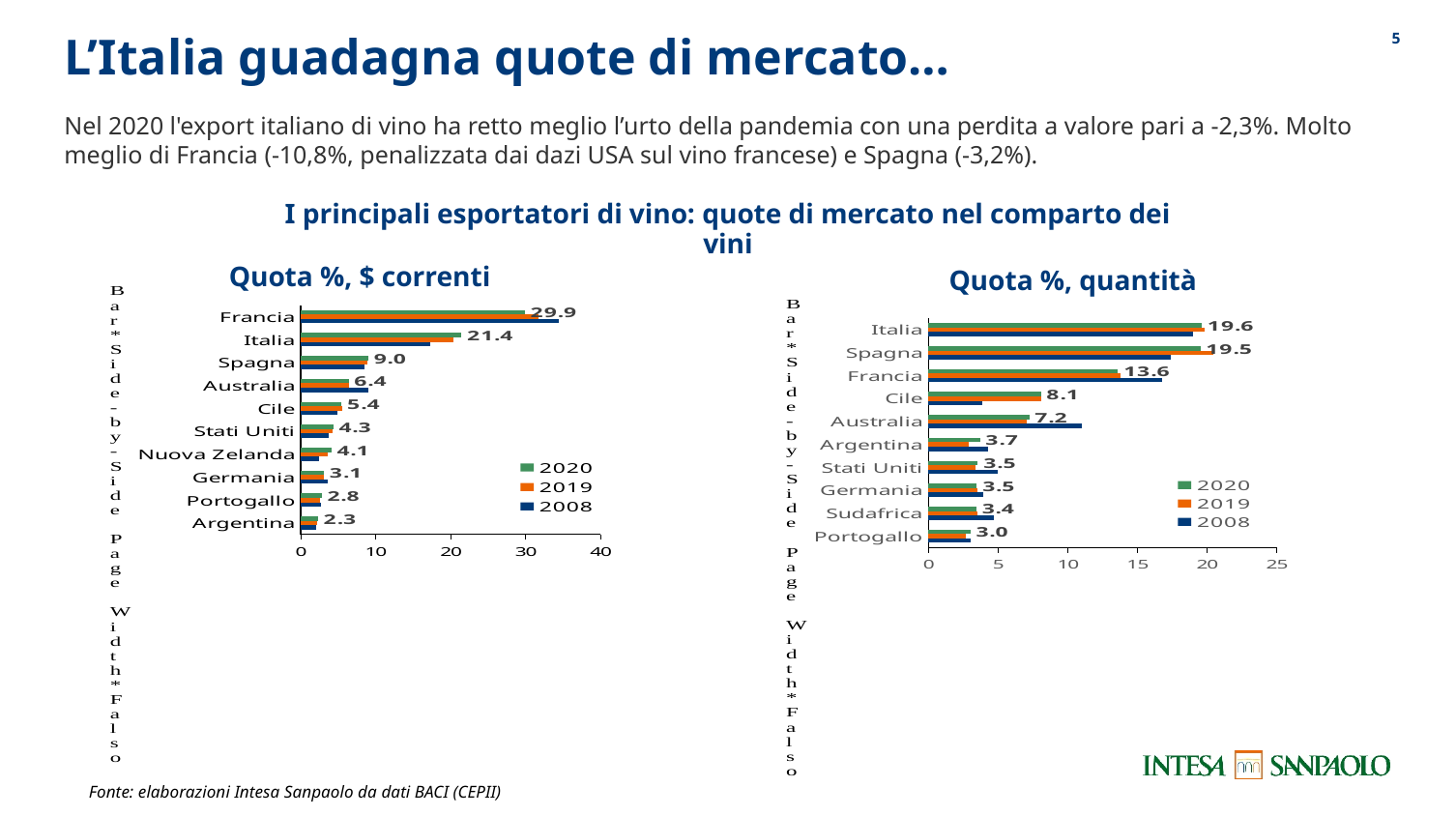
In the 'Quota %, quantità' chart, which country has the lowest 2020 value? Portogallo In the 'Quota %, $ correnti' chart, is the 2008 value for Francia greater or less than 30? greater What type of chart is the 'Quota %, quantità' chart? Bar chart In the 'Quota %, quantità' chart, what is the difference between the 2020 values for Cile and Australia? 0.9 In the 'Quota %, $ correnti' chart, what is the difference between the 2020 values for Francia and Italia? 8.5 In the 'Quota %, $ correnti' chart, which has the larger 2020 value, Spagna or Australia? Spagna How many series does the legend of the 'Quota %, $ correnti' chart list? 3 In the 'Quota %, quantità' chart, what is the 2020 value for Francia? 13.6 How many countries are shown in the 'Quota %, quantità' chart? 10 In the 'Quota %, quantità' chart, is the 2008 value for Australia greater or less than 10? greater In the 'Quota %, $ correnti' chart, which country has the highest 2020 value? Francia In the 'Quota %, $ correnti' chart, what is the 2020 value for Italia? 21.4